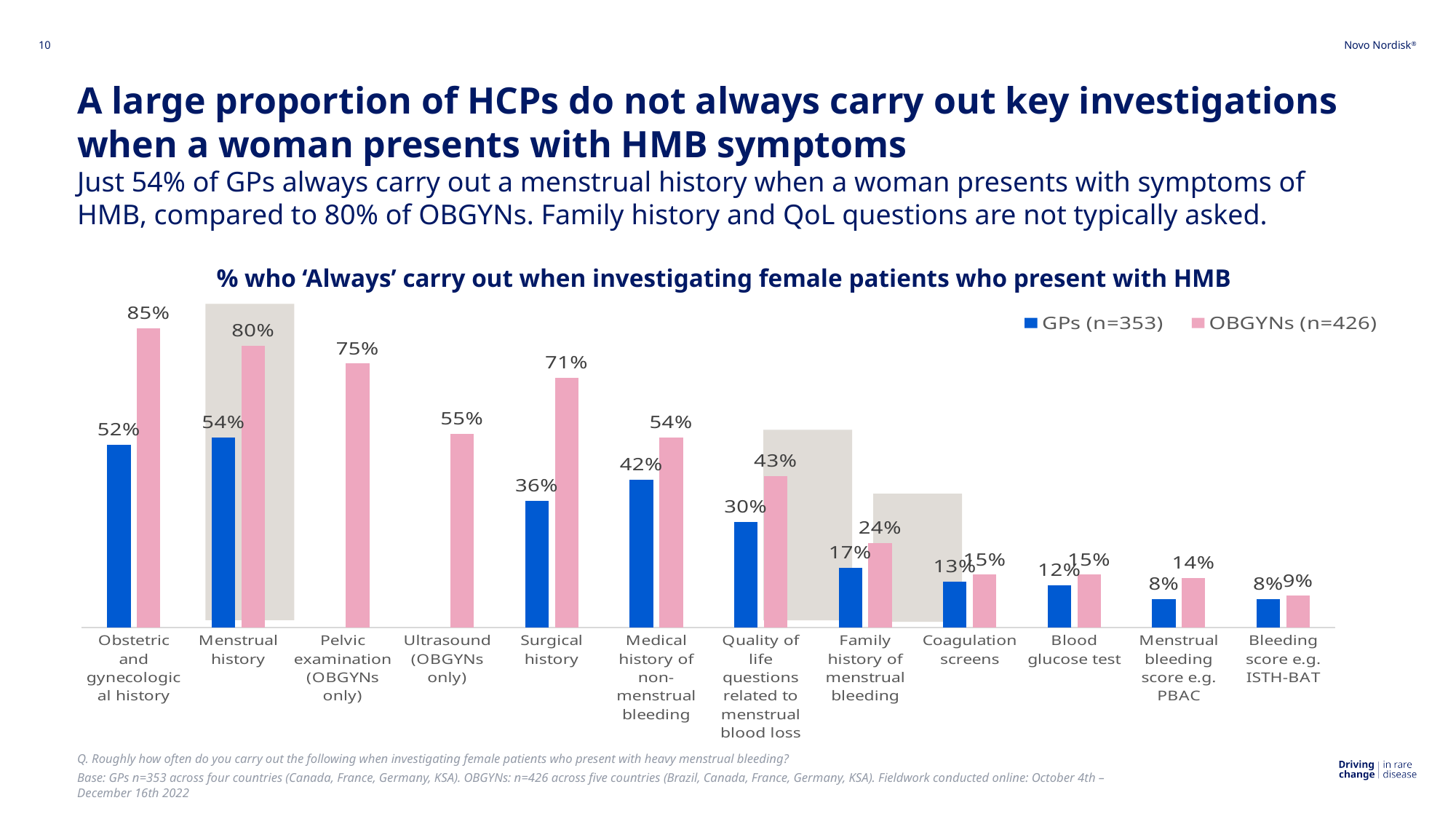
What kind of chart is shown? Bar chart Which is larger for quality of life questions related to menstrual blood loss: GPs or OBGYNs? OBGYNs What is the title of the chart? % who ‘Always’ carry out when investigating female patients who present with HMB What is the difference between OBGYNs and GPs for surgical history? 35% How many series does the legend list? 2 Which category has the lowest value for GPs? Menstrual bleeding score e.g. PBAC (tied with Bleeding score e.g. ISTH-BAT) What percentage of OBGYNs always carry out a surgical history? 71% What is the sample size for OBGYNs shown in the legend? n=426 What percentage of OBGYNs always carry out a pelvic examination? 75% What percentage of GPs always carry out a menstrual history? 54% Which category has the highest value for OBGYNs? Obstetric and gynecological history How many categories are shown on the x axis? 12